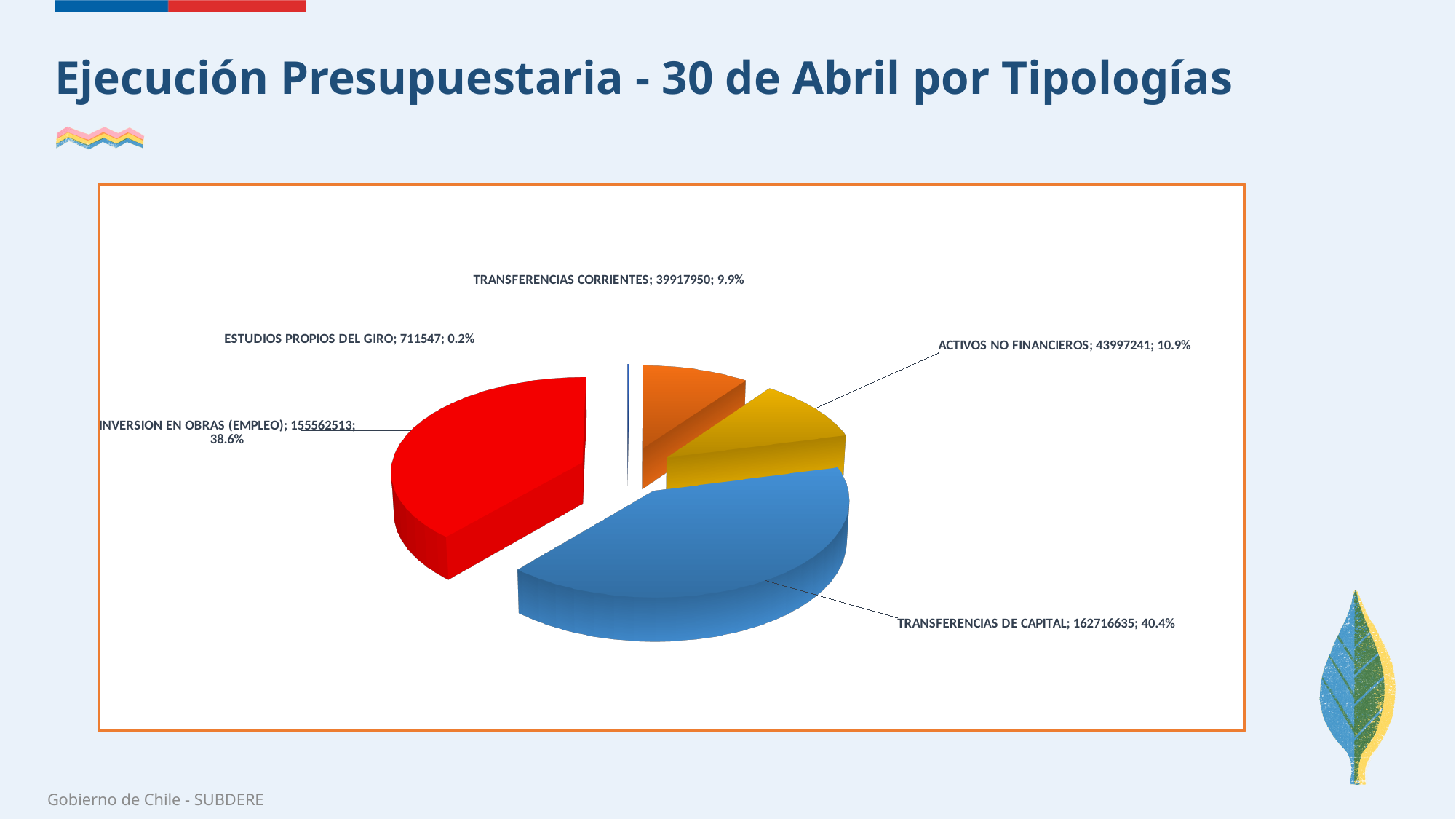
What colour is the slice for INVERSION EN OBRAS (EMPLEO)? Red Which category has the smallest slice of the pie? ESTUDIOS PROPIOS DEL GIRO What is the value for TRANSFERENCIAS DE CAPITAL? 162716635 What is the difference between the values for TRANSFERENCIAS DE CAPITAL and INVERSION EN OBRAS (EMPLEO)? 7154122 What kind of chart is shown on the slide? Pie chart What is the value for INVERSION EN OBRAS (EMPLEO)? 155562513 What share of the pie does TRANSFERENCIAS CORRIENTES represent? 9.9% Which is larger, the value for ACTIVOS NO FINANCIEROS or the value for TRANSFERENCIAS CORRIENTES? ACTIVOS NO FINANCIEROS How many slices does the pie chart have? 5 Which category has the largest slice of the pie? TRANSFERENCIAS DE CAPITAL What share of the pie does ACTIVOS NO FINANCIEROS represent? 10.9% What is the value for ESTUDIOS PROPIOS DEL GIRO? 711547